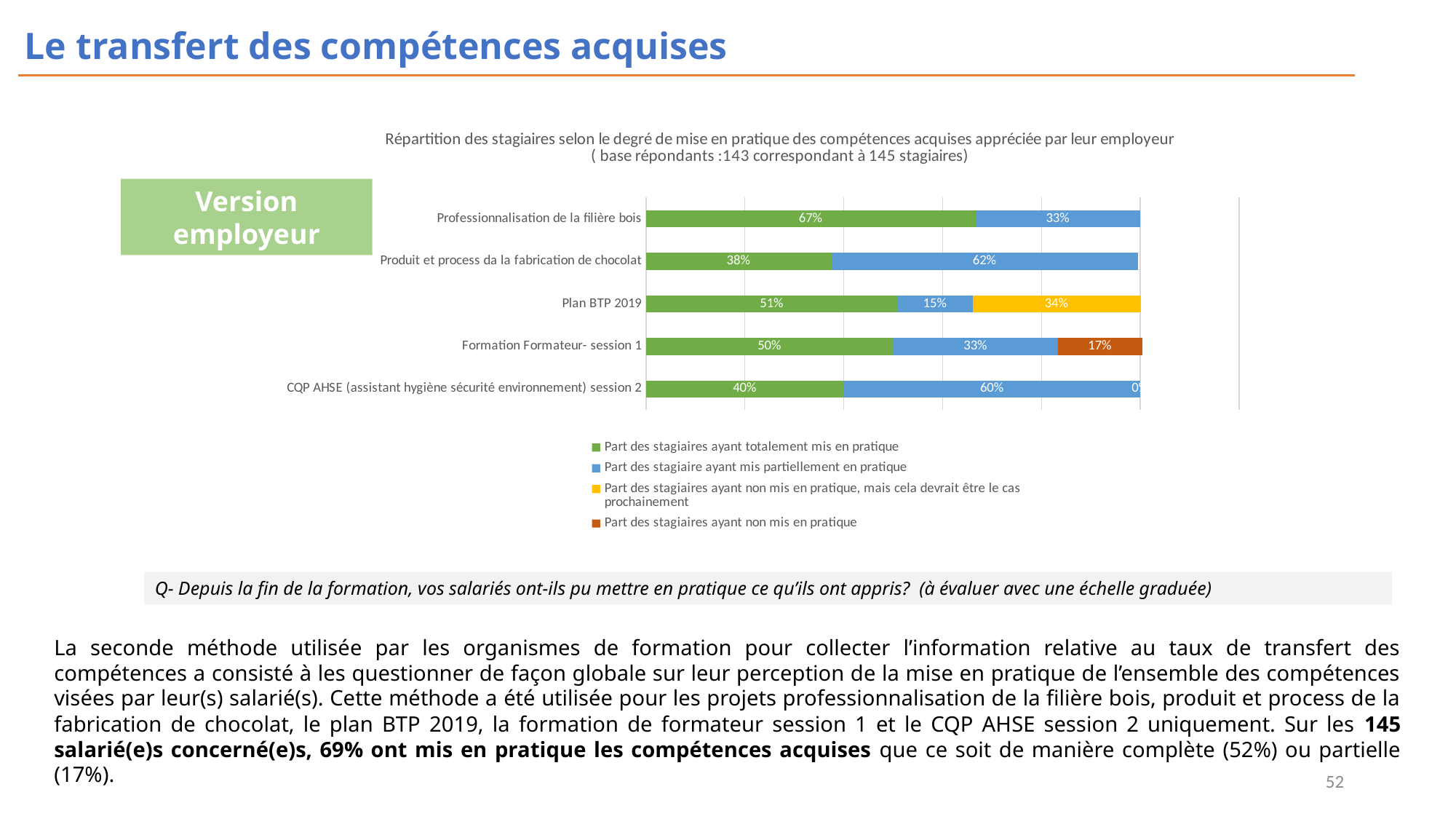
What is the total of the stacked bar for 'Plan BTP 2019'? 100% What is the value of the 'Part des stagiaires ayant non mis en pratique' segment for 'Formation Formateur- session 1'? 17% What is the difference between the green segment values of 'Professionnalisation de la filière bois' and 'CQP AHSE (assistant hygiène sécurité environnement) session 2'? 27% How many categories (training programmes) are shown on the chart? 5 What is the value of the 'Part des stagiaires ayant non mis en pratique, mais cela devrait être le cas prochainement' segment for 'Plan BTP 2019'? 34% Which has a larger blue (partial practice) segment: 'Plan BTP 2019' or 'Formation Formateur- session 1'? Formation Formateur- session 1 What is the partial practice (blue) value for 'Produit et process da la fabrication de chocolat'? 62% What percentage of trainees for 'Professionnalisation de la filière bois' totally put their skills into practice (green segment)? 67% Which category has the highest share of trainees who totally put their skills into practice (green segment)? Professionnalisation de la filière bois How many series does the legend list? 4 Which category has the lowest share of trainees who totally put their skills into practice (green segment)? Produit et process da la fabrication de chocolat What kind of chart is shown on the slide? Stacked bar chart